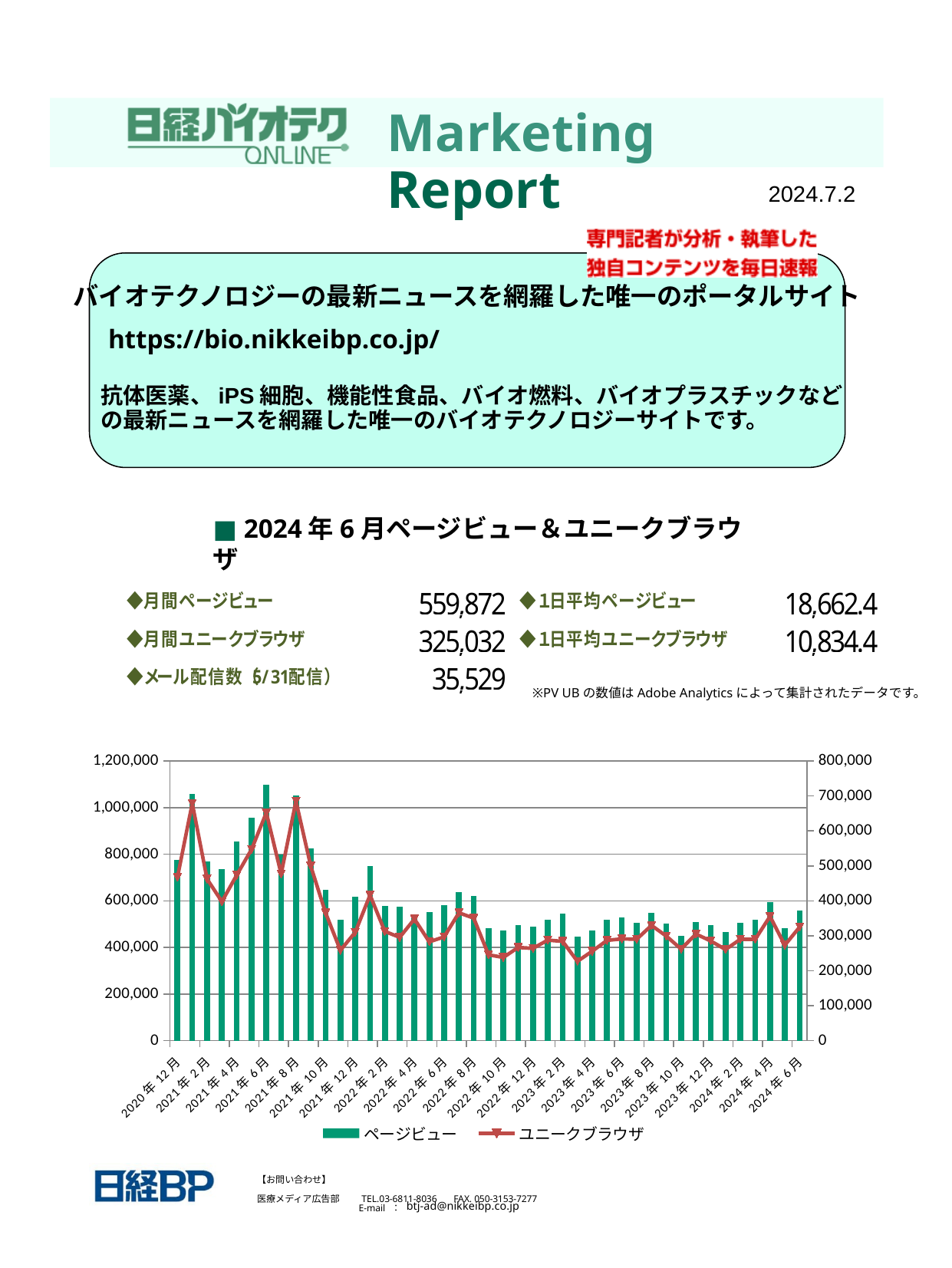
In which month is the ページビュー bar highest? 2021年6月 How many series does the chart legend list? 2 Which series is drawn as bars in the chart? ページビュー Is the ユニークブラウザ value for 2024年6月 greater or less than 400,000 on the right axis? less Which month has the larger ページビュー value, 2021年6月 or 2024年6月? 2021年6月 Is the ユニークブラウザ value for 2021年2月 greater or less than 600,000 on the right axis? less Is the ページビュー value for 2021年6月 greater or less than 1,000,000? greater What kind of chart is shown at the bottom of the slide? A combined bar and line chart What are the two series named in the chart legend? ページビュー and ユニークブラウザ Do the ページビュー values generally rise or fall from 2021 to 2024 along the x axis? fall What is the maximum value shown on the left vertical axis of the chart? 1,200,000